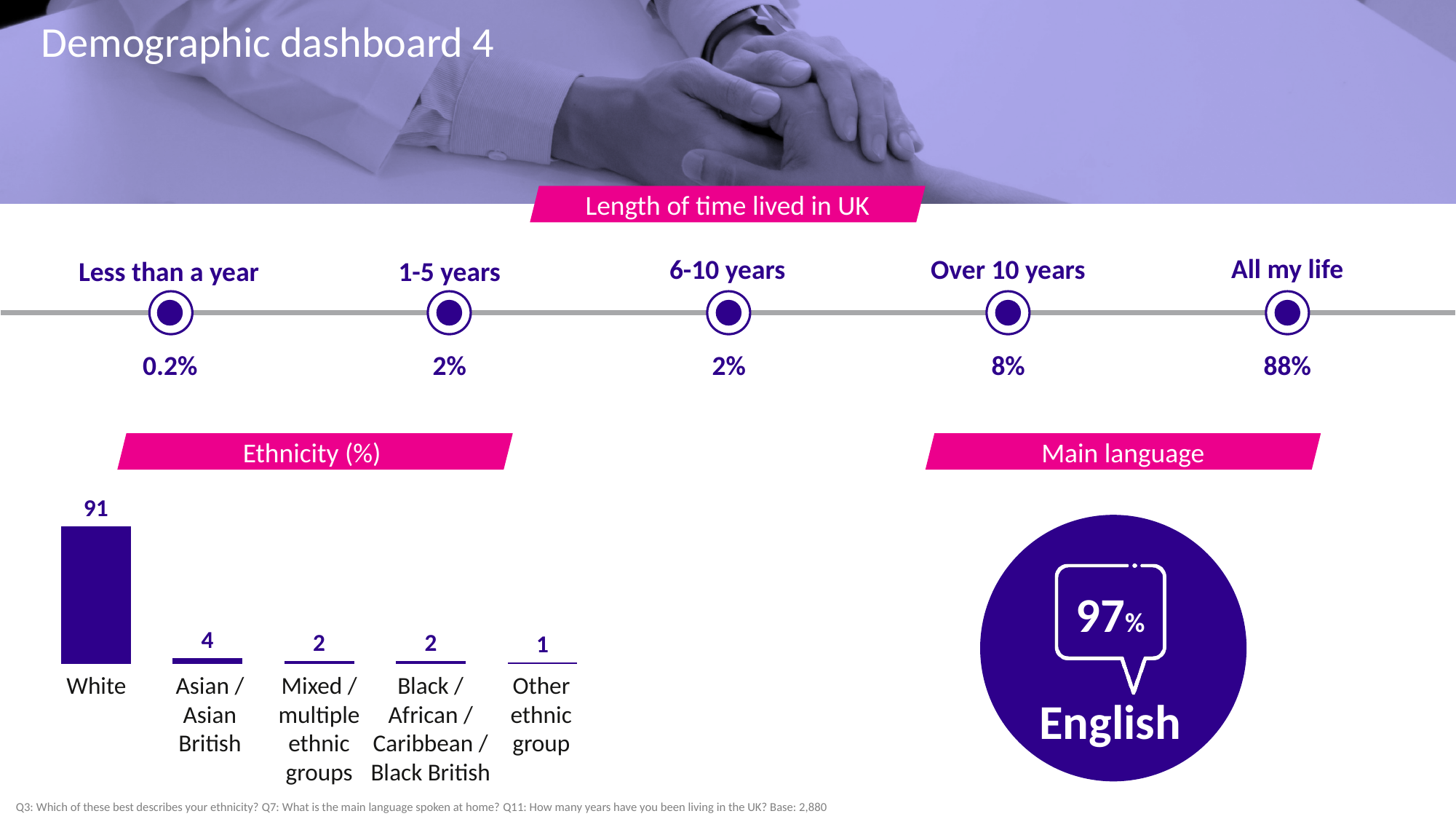
In the Ethnicity (%) chart, which category has the lowest value? Other ethnic group In the Length of time lived in UK timeline, what is the value for Less than a year? 0.2% In the Ethnicity (%) chart, which is larger: Asian / Asian British or Mixed / multiple ethnic groups? Asian / Asian British What kind of chart is the Ethnicity (%) chart? Bar chart How many categories does the Ethnicity (%) chart show? 5 In the Ethnicity (%) chart, which category has the highest value? White In the Length of time lived in UK timeline, what is the value for All my life? 88% In the Length of time lived in UK timeline, what is the difference between the values for All my life and Over 10 years? 80% In the Ethnicity (%) chart, what is the value for Other ethnic group? 1 In the Ethnicity (%) chart, what is the difference between the values for White and Asian / Asian British? 87 In the Ethnicity (%) chart, what is the value for Asian / Asian British? 4 In the Ethnicity (%) chart, what is the value for White? 91